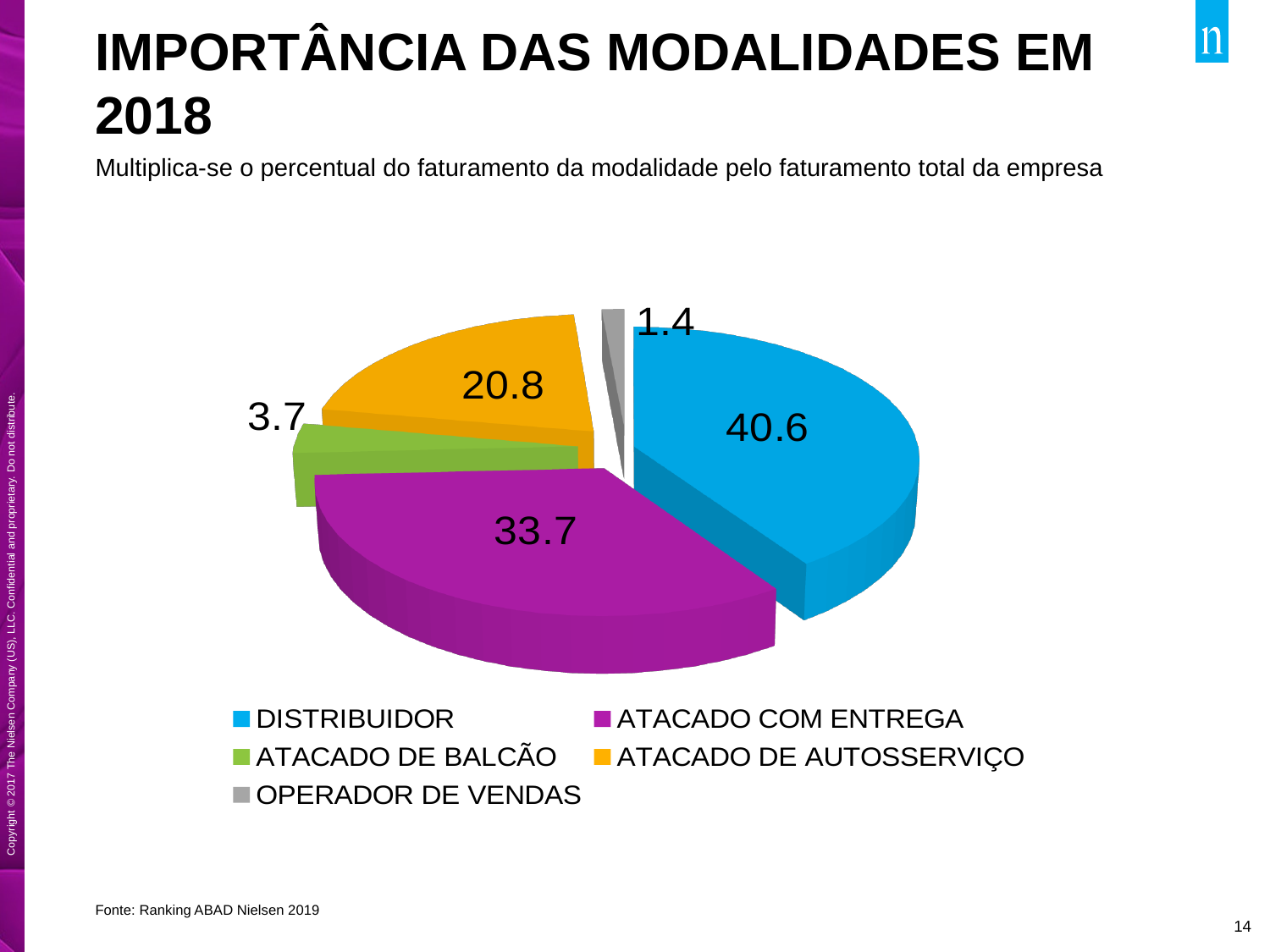
What value is shown for the ATACADO DE AUTOSSERVIÇO slice? 20.8 Which is larger, ATACADO COM ENTREGA or ATACADO DE AUTOSSERVIÇO? ATACADO COM ENTREGA How many categories does the pie chart show? 5 What is the difference between the ATACADO DE AUTOSSERVIÇO value and the ATACADO DE BALCÃO value? 17.1 What kind of chart is shown on the slide? Pie chart What value is shown for the OPERADOR DE VENDAS slice? 1.4 What value is shown for the ATACADO COM ENTREGA slice? 33.7 What is the difference between the DISTRIBUIDOR value and the ATACADO COM ENTREGA value? 6.9 What value is shown for the ATACADO DE BALCÃO slice? 3.7 What value is shown for the DISTRIBUIDOR slice? 40.6 Which category has the smallest slice of the pie? OPERADOR DE VENDAS Which category has the largest slice of the pie? DISTRIBUIDOR